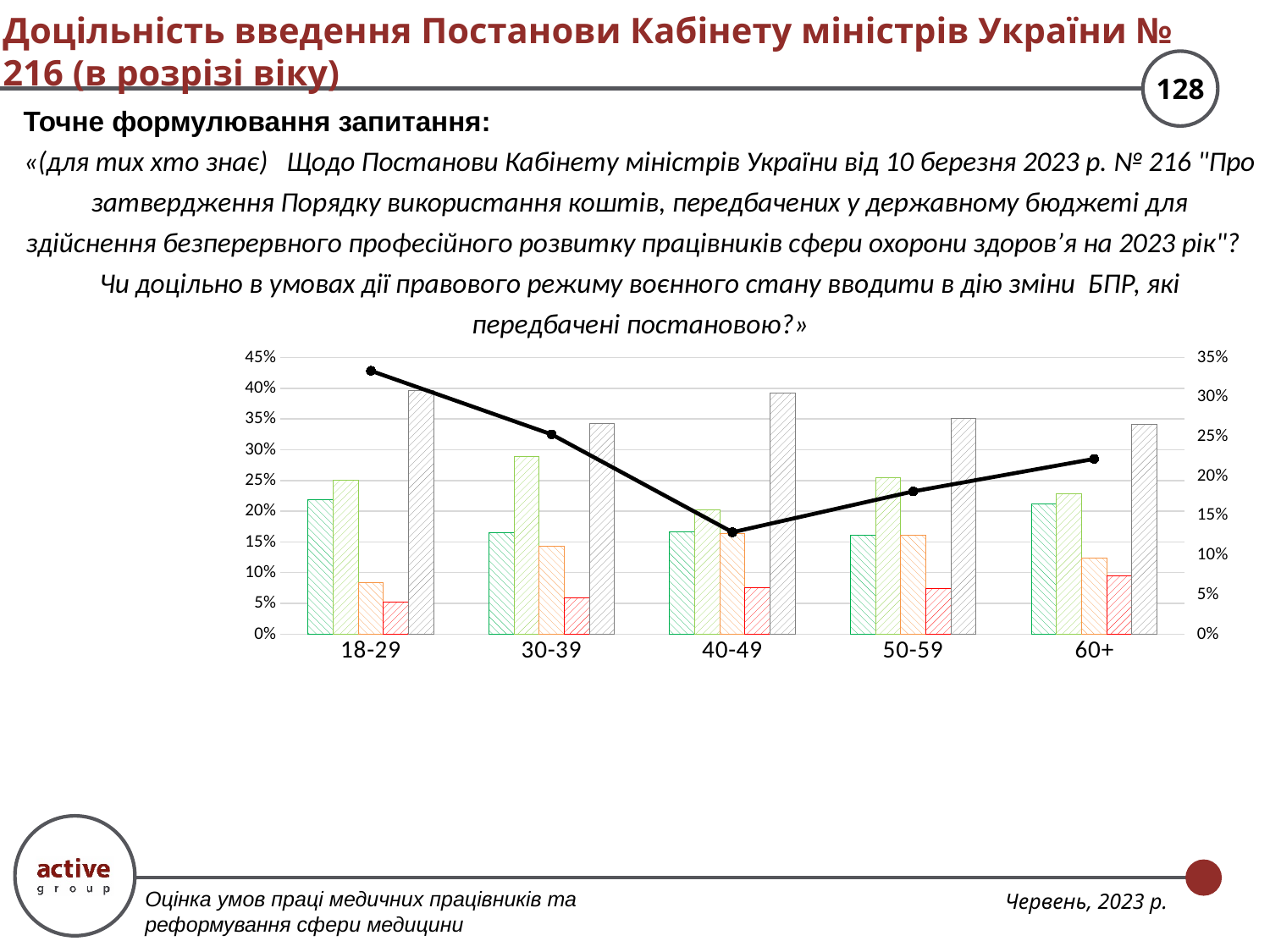
How many age categories are shown on the x axis of the chart? 5 Is the value of the red hatched bar for 18-29 greater or less than 10% on the left axis? less What kind of chart is shown on the slide? A bar chart combined with a line Which age category has the highest point on the black line? 18-29 How many bars are plotted for each age category in the chart? 5 For the 40-49 category, which is larger: the grey hatched bar or the red hatched bar? The grey hatched bar What is the maximum value shown on the left vertical axis of the chart? 45% Does the black line rise or fall from 18-29 to 40-49? Falls Is the black line's value for 40-49 greater or less than 15% on the right axis? less Is the value of the rightmost (grey hatched) bar for 18-29 greater or less than 35% on the left axis? greater Which age category has the lowest point on the black line? 40-49 Does the black line rise or fall from 40-49 to 60+? Rises